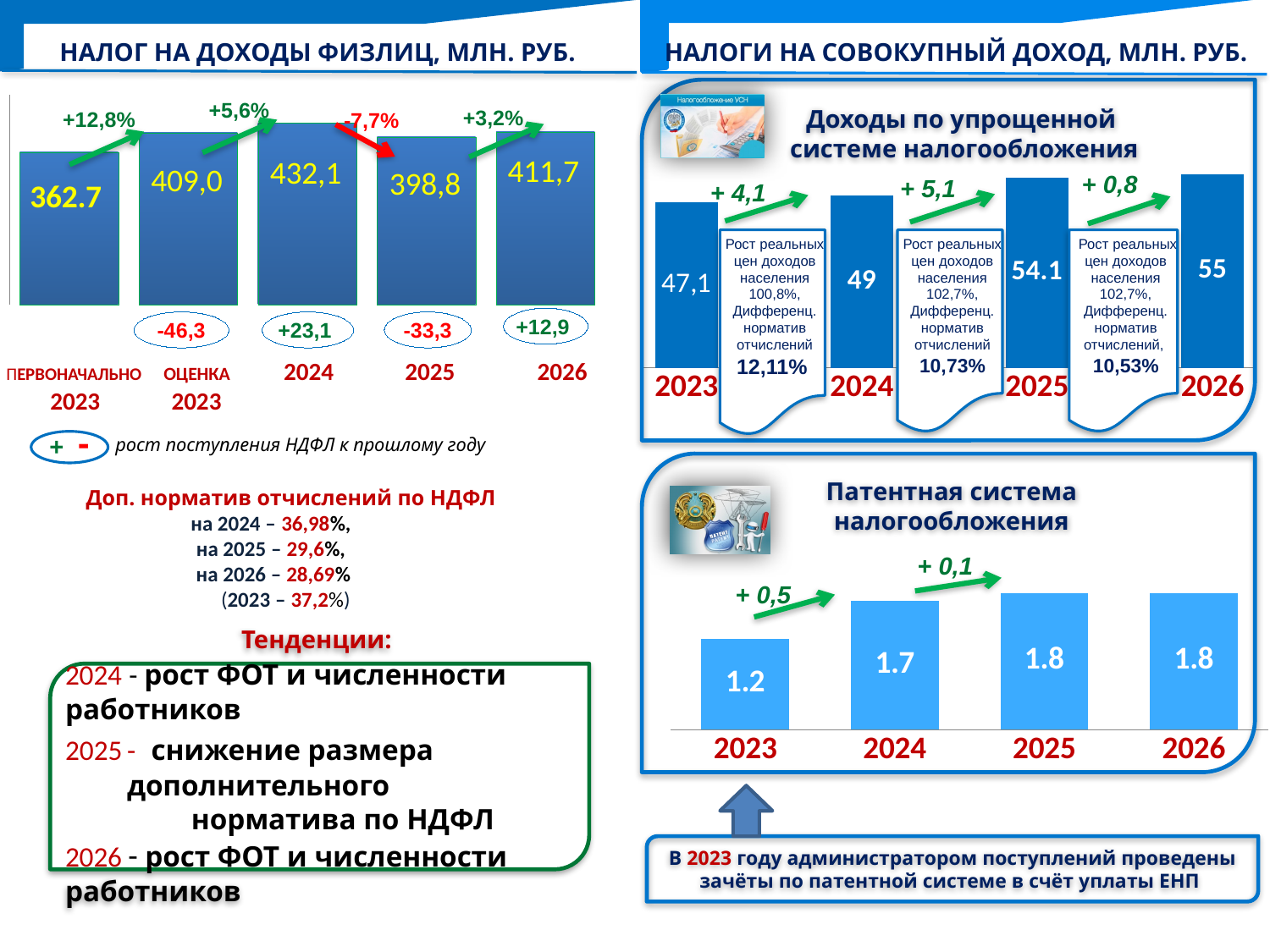
On the 'Доходы по упрощенной системе налогообложения' chart, do the values rise or fall from 2023 to 2026? rise On the 'Доходы по упрощенной системе налогообложения' chart, what is the value for 2025? 54.1 On the 'Налог на доходы физлиц' chart, what is the value for 'Оценка 2023'? 409,0 On the 'Налог на доходы физлиц' chart, which is larger, the value for 2025 or the value for 2026? 2026 On the 'Налог на доходы физлиц' chart, which category has the lowest value? Первоначально 2023 On the 'Доходы по упрощенной системе налогообложения' chart, which year has the lowest value? 2023 What type of chart is the 'Патентная система налогообложения' chart? bar chart On the 'Налог на доходы физлиц' chart, which category has the highest value? 2024 On the 'Налог на доходы физлиц' chart, how many bars are shown? 5 On the 'Патентная система налогообложения' chart, what is the value for 2023? 1.2 On the 'Налог на доходы физлиц' chart, what is the value for 2024? 432,1 On the 'Патентная система налогообложения' chart, what is the difference between the values for 2024 and 2023? 0.5